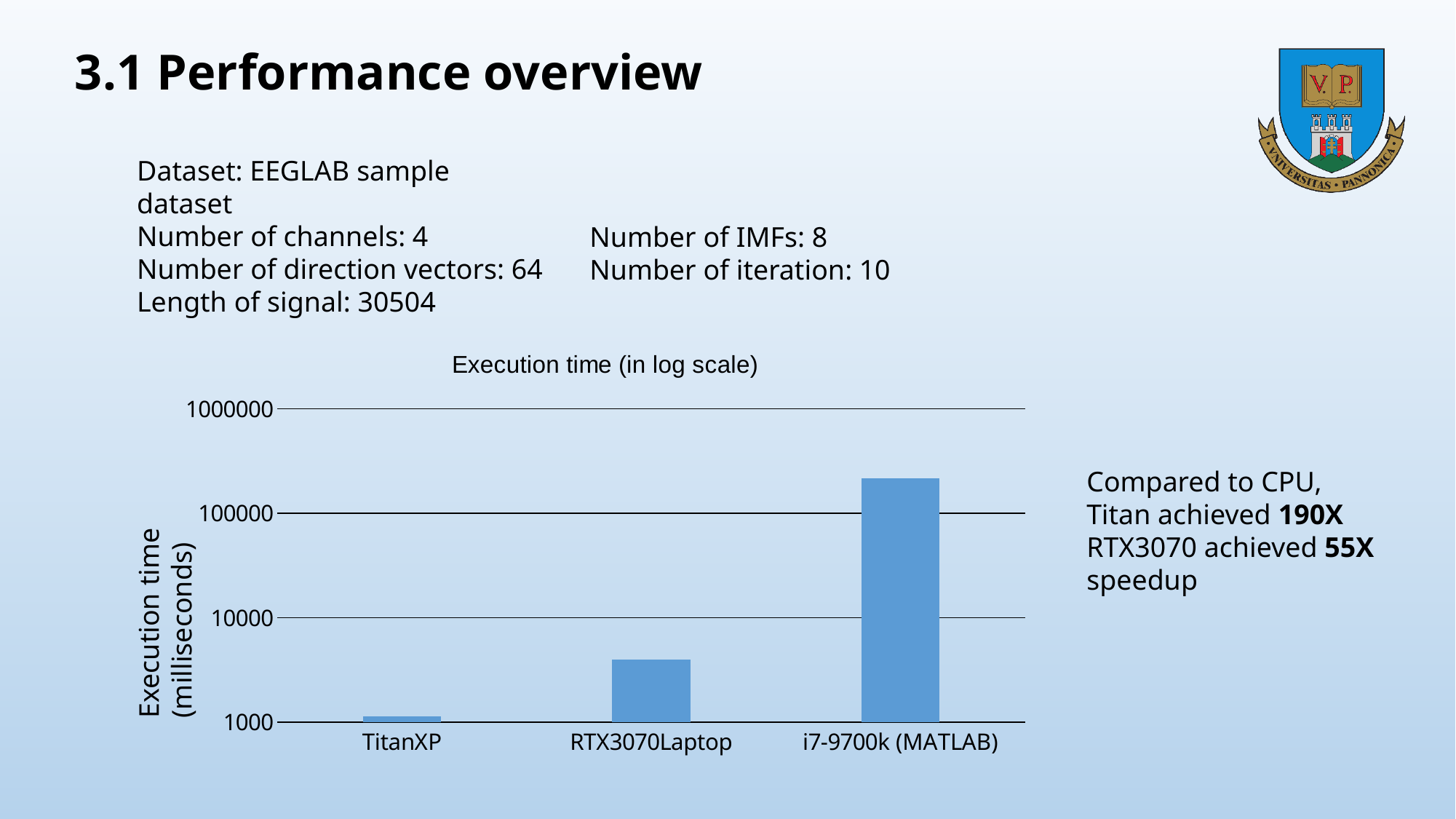
What type of chart is shown on the slide? bar chart Do the execution times rise or fall from left to right along the x axis? rise Is the execution time for TitanXP greater or less than 10000? less Which has a larger execution time, TitanXP or RTX3070Laptop? RTX3070Laptop Which category has the highest execution time in the chart? i7-9700k (MATLAB) What is the title of the chart? Execution time (in log scale) Which category has the lowest execution time in the chart? TitanXP Is the execution time for i7-9700k (MATLAB) greater or less than 100000? greater What is the label of the vertical axis of the chart? Execution time (milliseconds) How many categories are plotted on the x axis of the chart? 3 Is the execution time for RTX3070Laptop greater or less than 10000? less Which has a larger execution time, RTX3070Laptop or i7-9700k (MATLAB)? i7-9700k (MATLAB)